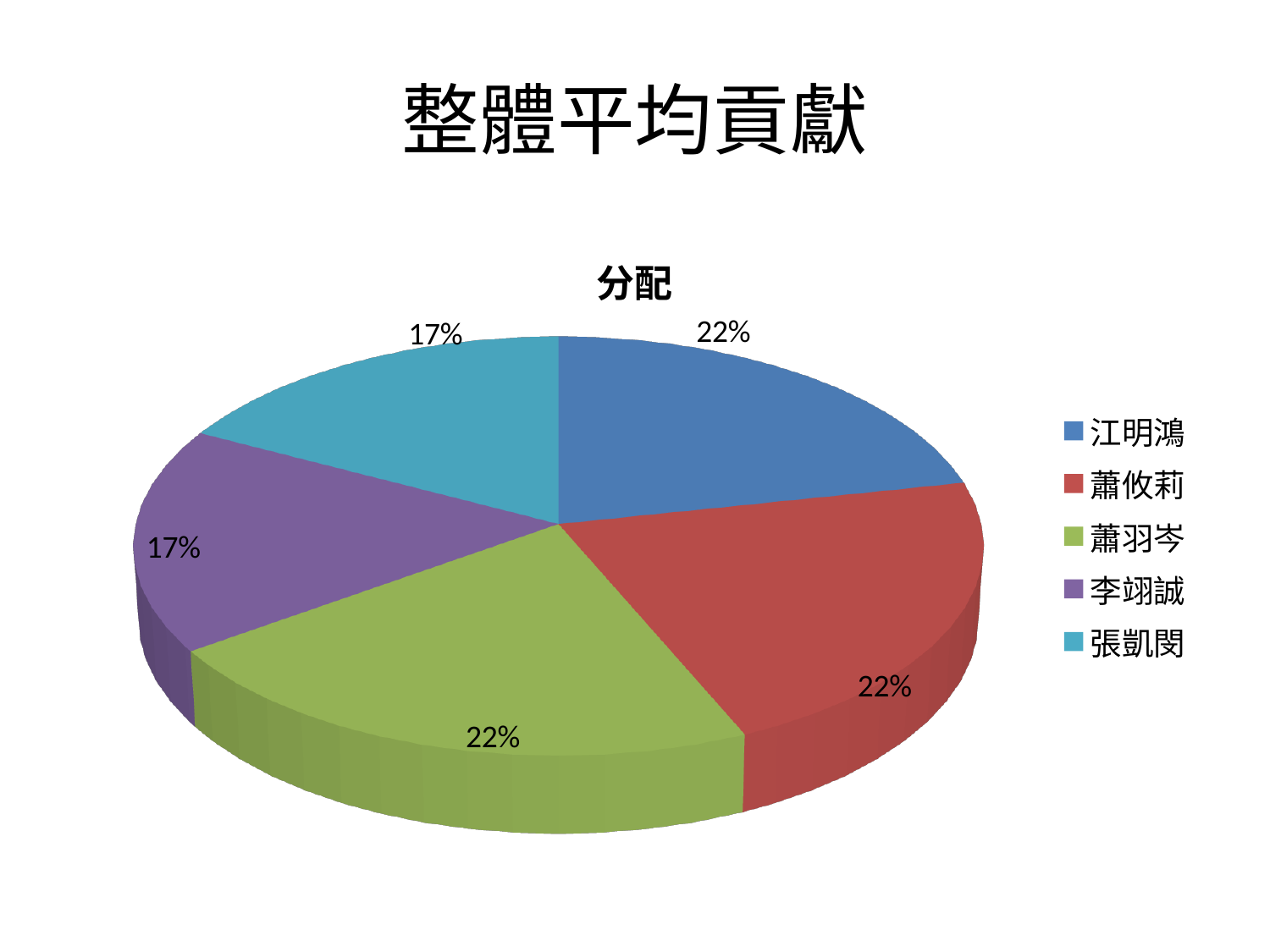
What share of the pie does 江明鴻 have? 22% What share of the pie does 李翊誠 have? 17% What share of the pie does 張凱閔 have? 17% What is the difference between the shares of 蕭攸莉 and 張凱閔? 5% What kind of chart is shown on the slide? pie chart Which has the larger share, 張凱閔 or 蕭羽岑? 蕭羽岑 What is the chart's title? 分配 Which colour is the slice for 李翊誠? purple How many slices does the pie chart have? 5 Which has the larger share, 江明鴻 or 李翊誠? 江明鴻